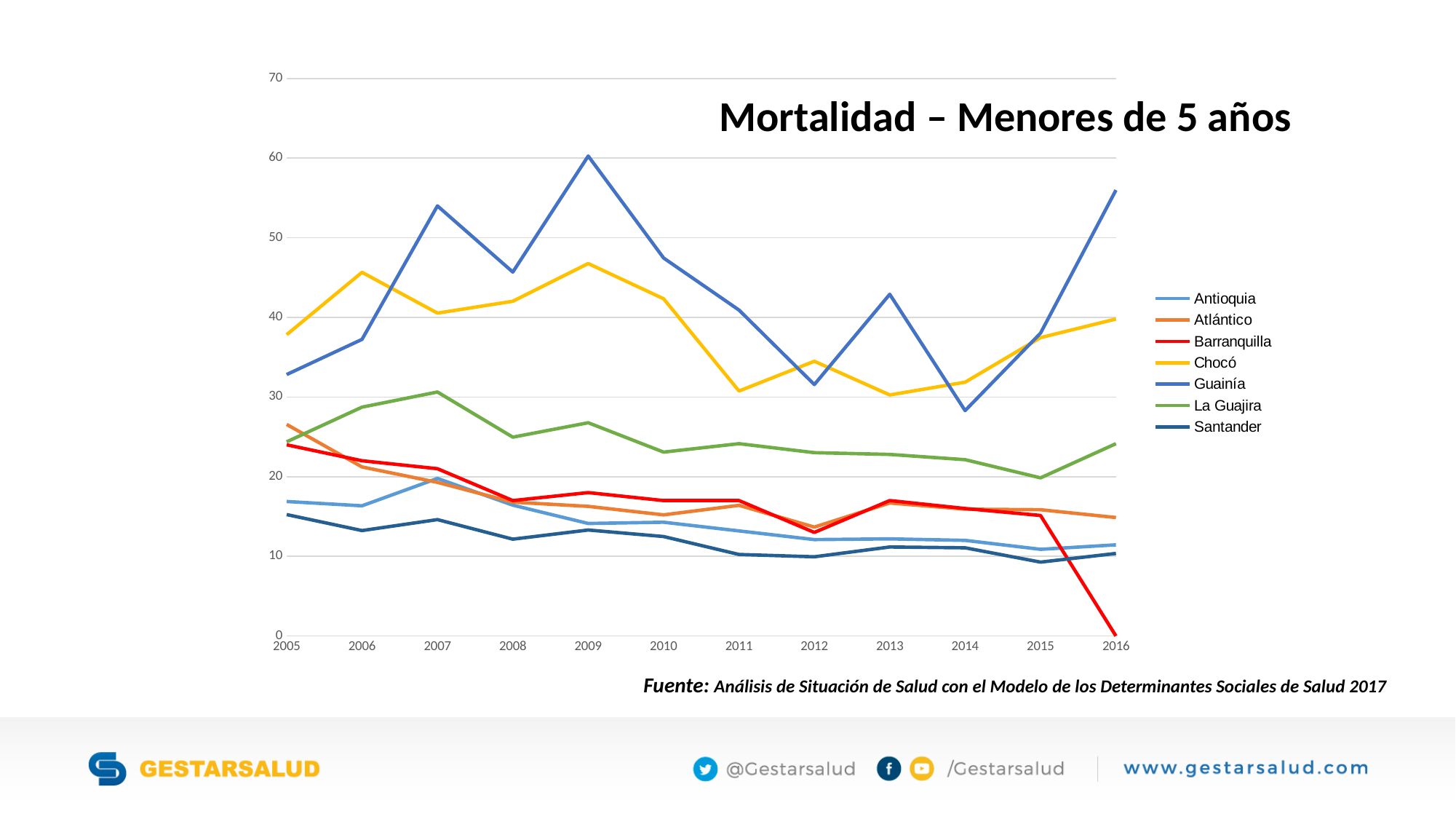
Is the value for Barranquilla in 2016 greater or less than 10? less How many series does the legend list? 7 Is the value for Antioquia in 2005 greater or less than 20? less What kind of chart is shown on the slide? line chart Is the value for Chocó in 2006 greater or less than 40? greater What is the title of the chart? Mortalidad – Menores de 5 años How many years are shown along the x axis? 12 In 2005, which is larger, the value for Chocó or the value for Guainía? Chocó Which series has the lowest value in 2016? Barranquilla Which series has the highest value in 2016? Guainía In which year does the Guainía series reach its highest value? 2009